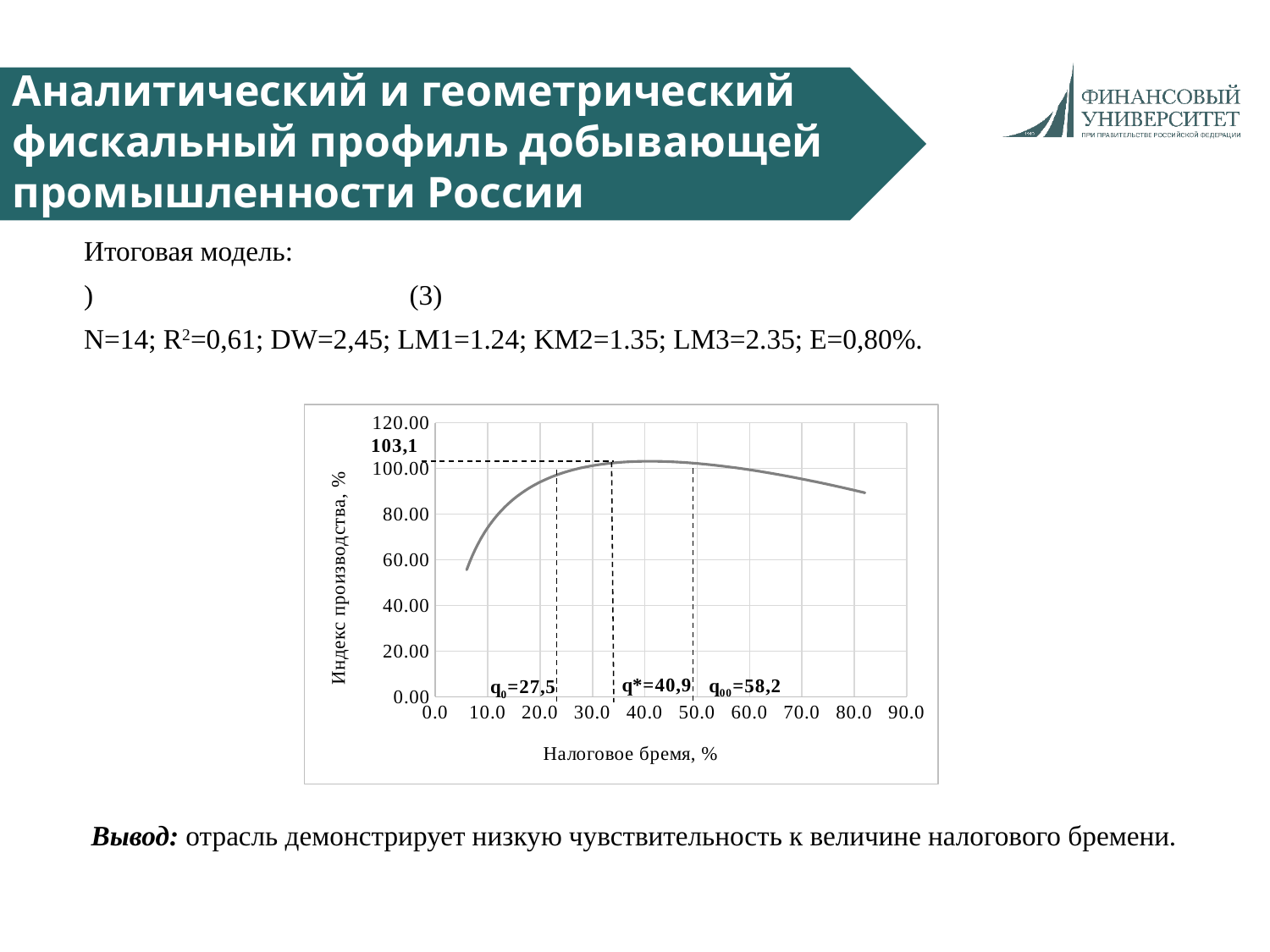
Is the production index at a tax burden of 10 greater or less than 40? greater What kind of chart is shown on the slide? line chart What is the maximum value of the production index marked on the chart? 103,1 What is the highest tick value shown on the y axis of the chart? 120.00 What is the label of the x axis of the chart? Налоговое бремя, % Is the production index at a tax burden of 80 greater or less than 100? less What is the label of the y axis of the chart? Индекс производства, % Does the production index rise or fall as the tax burden increases from 10 to 40? rises Does the production index rise or fall as the tax burden increases from 50 to 80? falls What value of the tax burden is marked as q* on the chart? 40,9 What value of the tax burden is marked as q0 on the chart? 27,5 What value of the tax burden is marked as q00 on the chart? 58,2